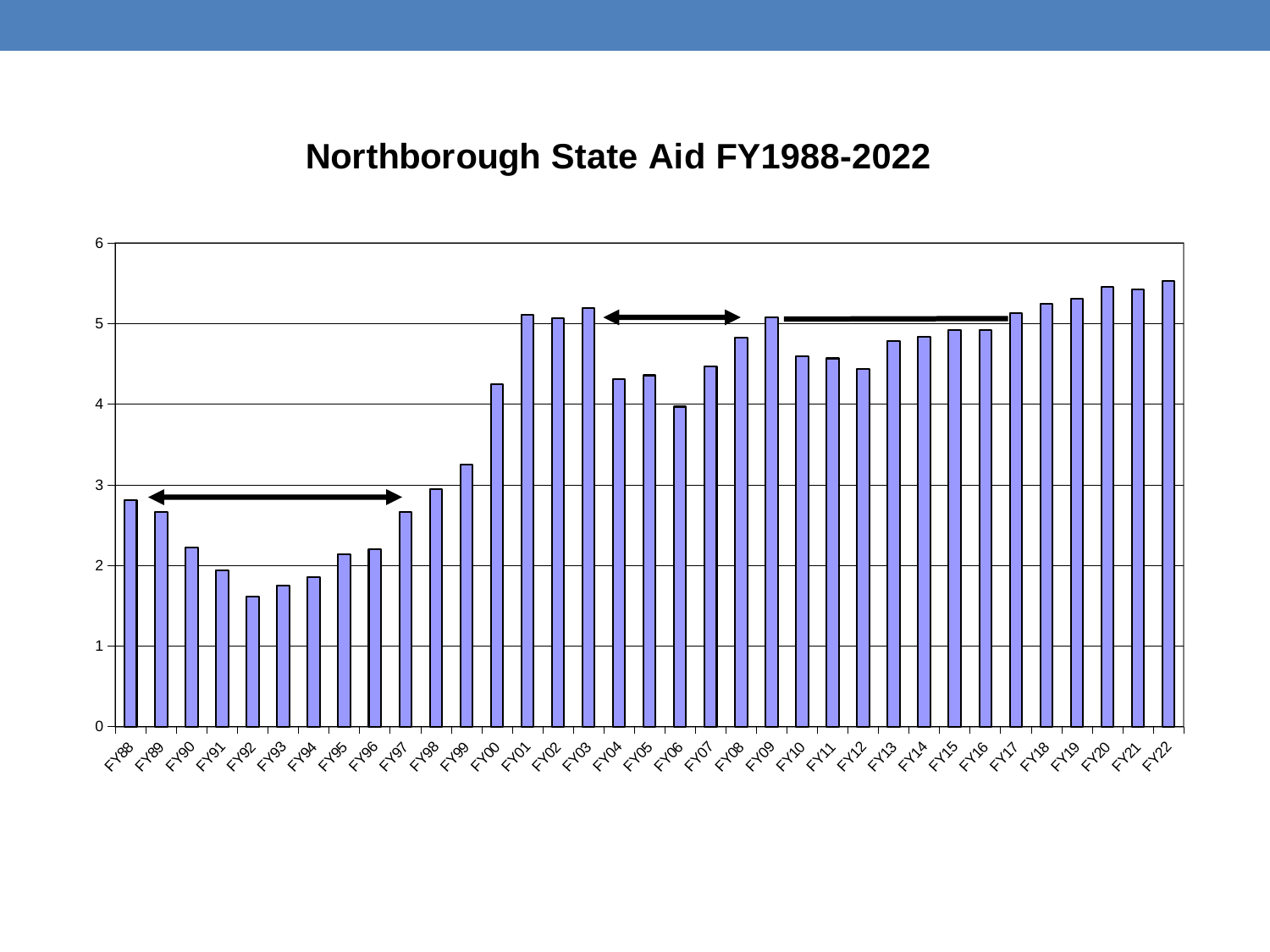
Do the values rise or fall from FY88 to FY92? fall What kind of chart is shown on the slide? bar chart Is the value for FY22 greater or less than 5? greater Which is larger, the value for FY92 or the value for FY97? FY97 Which is larger, the value for FY03 or the value for FY04? FY03 Which fiscal year has the lowest value on the chart? FY92 What is the title of the chart? Northborough State Aid FY1988-2022 Is the value for FY92 greater or less than 2? less Is the value for FY01 greater or less than 5? greater How many fiscal years (bars) are plotted on the chart? 35